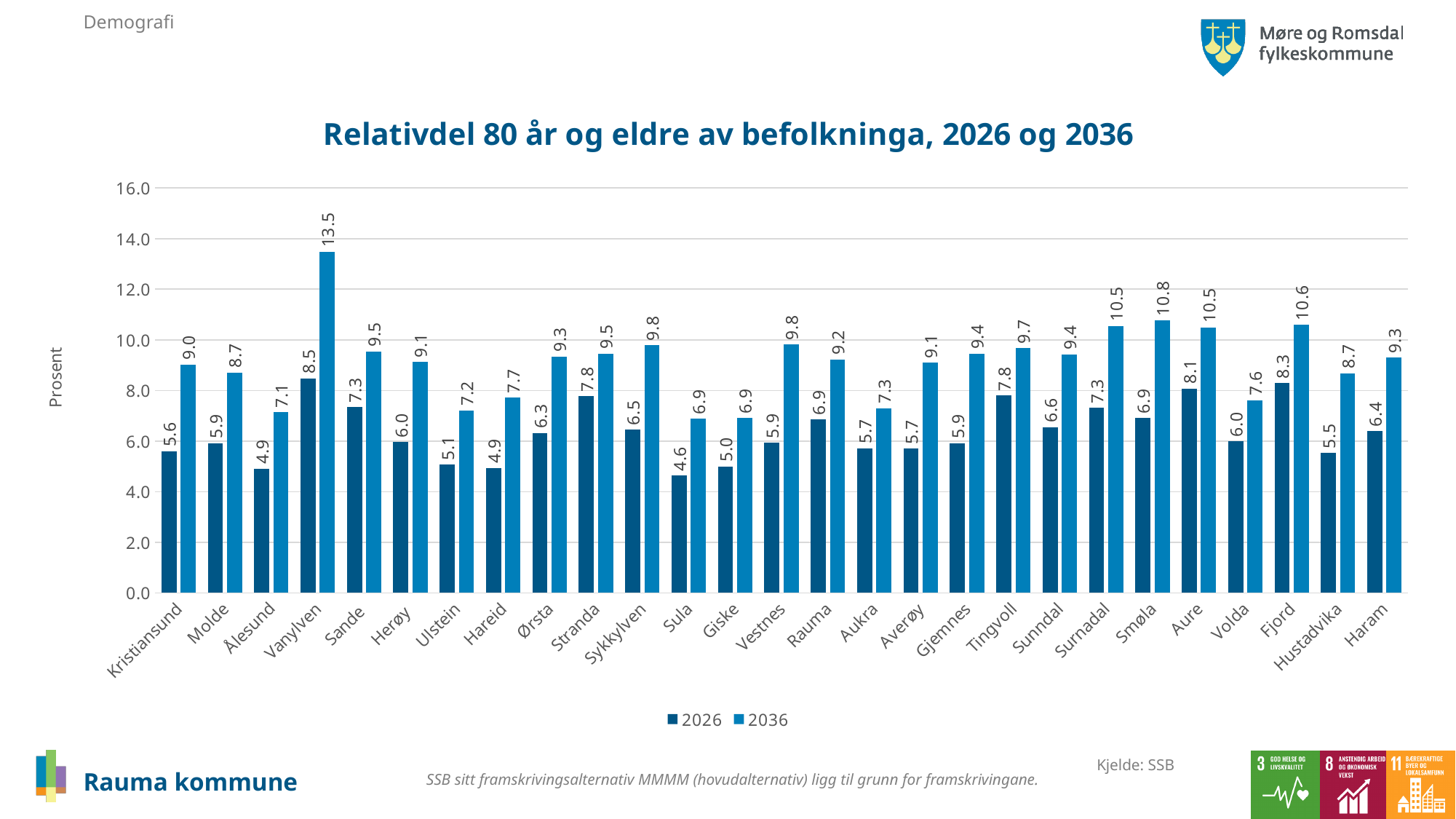
Which municipality has the highest value in 2036? Vanylven What is the value for Vanylven in 2026? 8.5 Which is larger, the 2026 value for Fjord or the 2026 value for Aure? Fjord What is the value for Rauma in 2036? 9.2 How many municipalities are shown on the x axis? 27 What is the value for Hustadvika in 2036? 8.7 What is the difference between the 2036 values for Smøla and Surnadal? 0.3 Is the 2036 value for Vanylven greater or less than 12.0? greater How many series does the legend list? 2 What is the difference between the 2036 and 2026 values for Vanylven? 5.0 What kind of chart is shown on the slide? Bar chart Which municipality has the lowest value in 2026? Sula